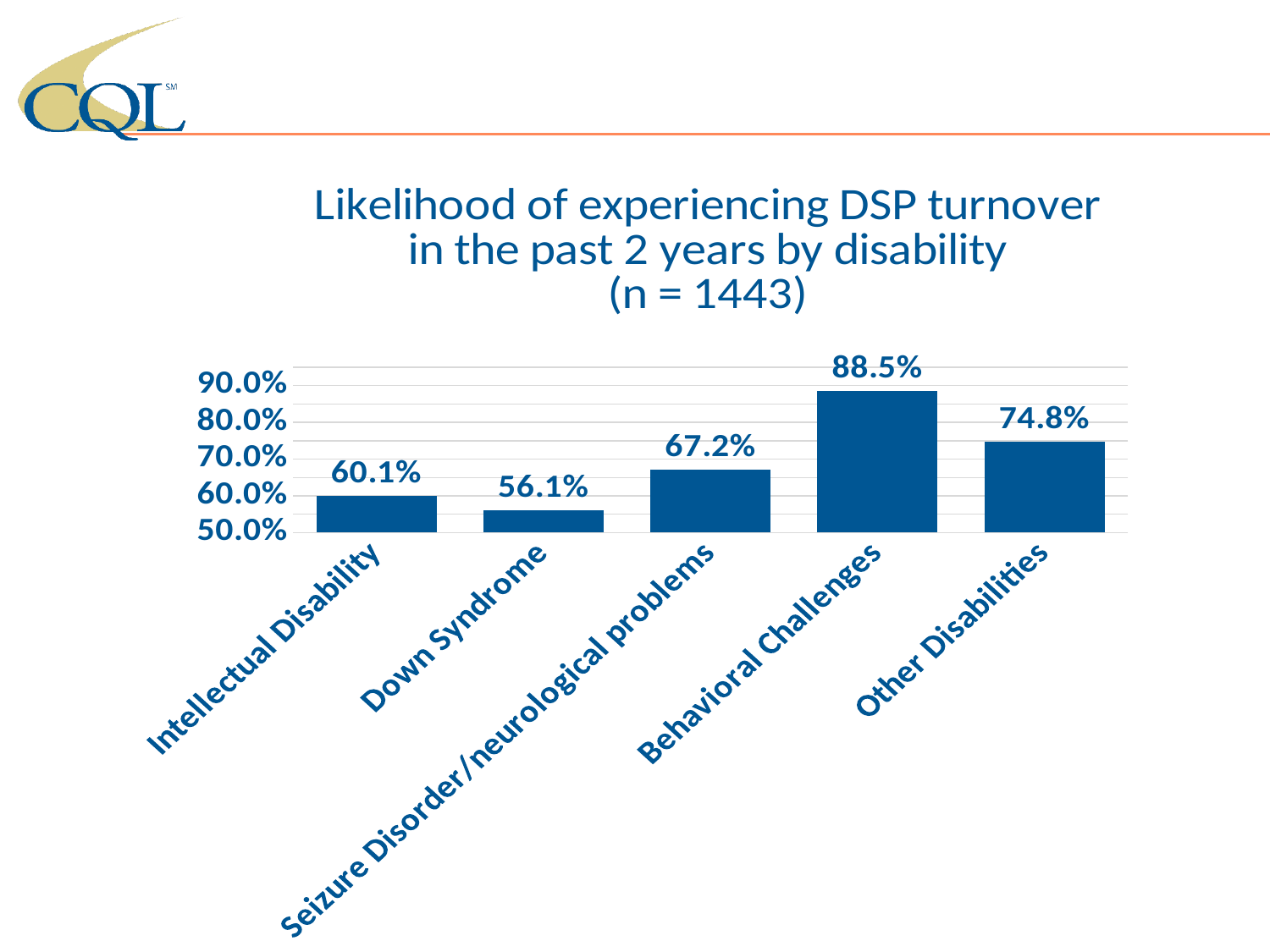
What kind of chart is shown on the slide? bar chart How many categories are shown on the chart? 5 What is the value for Seizure Disorder/neurological problems? 67.2% What is the value for Down Syndrome? 56.1% Is the value for Intellectual Disability greater or less than 70.0%? less What sample size (n) is given in the chart title? 1443 Which category has the lowest value? Down Syndrome What is the value for Other Disabilities? 74.8% What is the difference between the values for Behavioral Challenges and Intellectual Disability? 28.4% Which category has the highest value? Behavioral Challenges Which is larger, the value for Other Disabilities or the value for Seizure Disorder/neurological problems? Other Disabilities What is the value for Behavioral Challenges? 88.5%